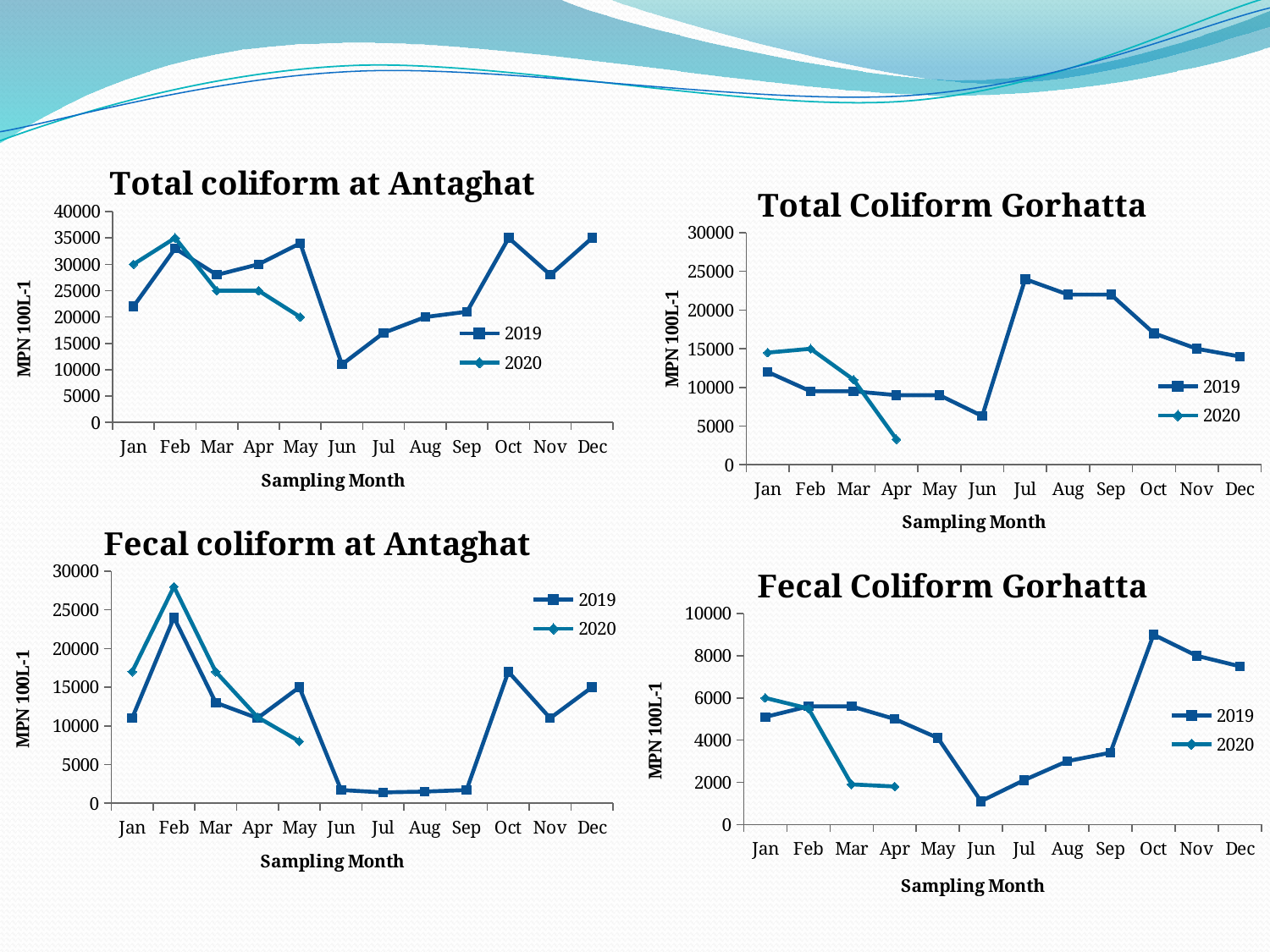
In the 'Fecal coliform at Antaghat' chart, how many sampling months are shown on the x axis? 12 In the 'Fecal Coliform Gorhatta' chart, what is the 2020 value for Jan? 6000 In the 'Fecal coliform at Antaghat' chart, which month has the highest 2019 value? Feb In the 'Total Coliform Gorhatta' chart, which month has the lowest 2019 value? Jun In the 'Fecal Coliform Gorhatta' chart, which month has the highest 2019 value? Oct In the 'Fecal coliform at Antaghat' chart, which series has the larger value in Feb, 2019 or 2020? 2020 In the 'Fecal Coliform Gorhatta' chart, do the 2019 values rise or fall from Oct to Dec? fall In the 'Total Coliform Gorhatta' chart, which month has the highest 2019 value? Jul In the 'Total Coliform Gorhatta' chart, how many series does the legend list? 2 What kind of chart is 'Total coliform at Antaghat'? line chart In the 'Total coliform at Antaghat' chart, is the 2019 value for Jun greater or less than 15000? less In the 'Fecal Coliform Gorhatta' chart, which month has the lowest 2019 value? Jun